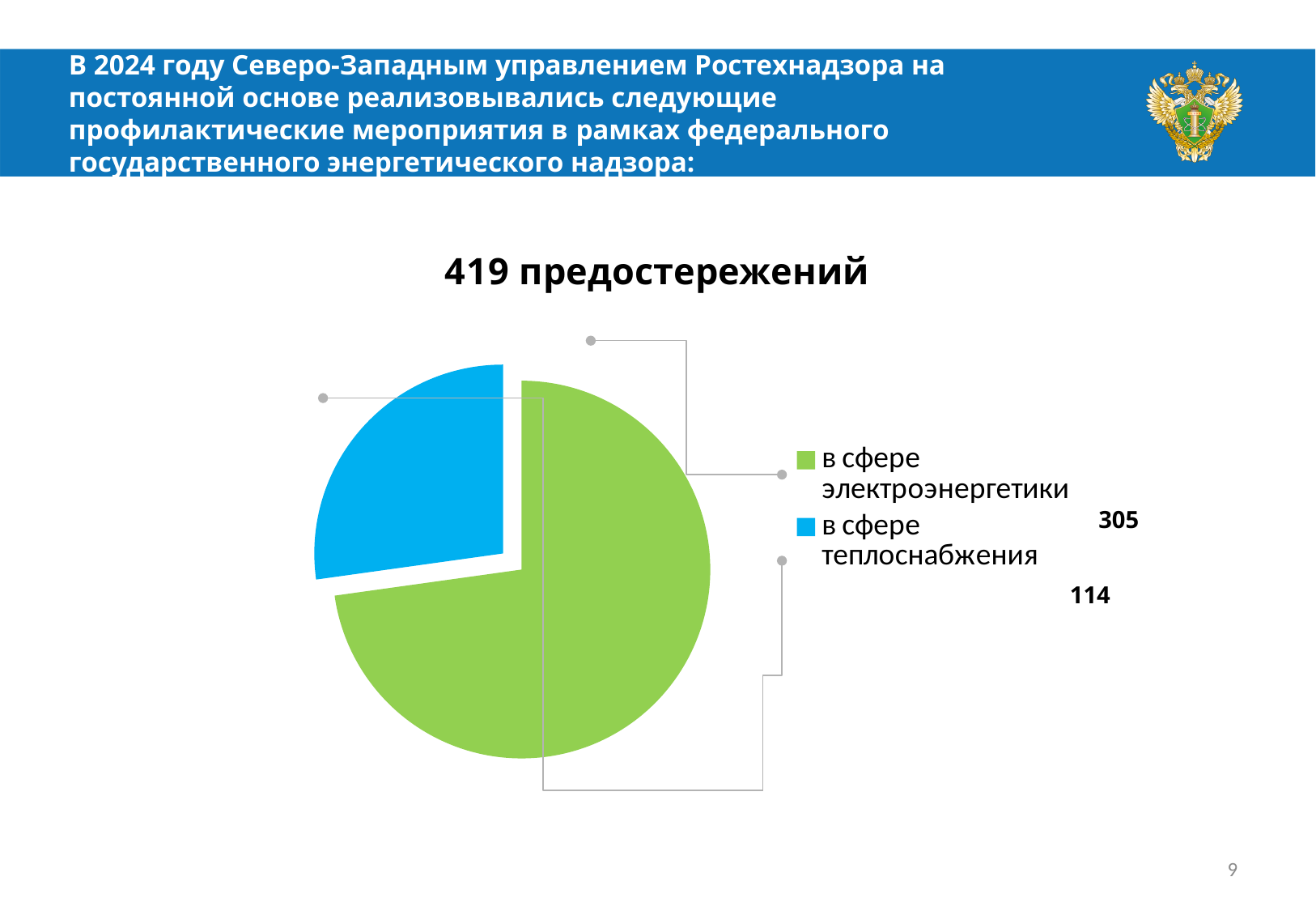
What is the difference between the values for "в сфере электроэнергетики" and "в сфере теплоснабжения"? 191 What kind of chart is shown on the slide? pie chart Which is larger: the value for "в сфере электроэнергетики" or for "в сфере теплоснабжения"? в сфере электроэнергетики How many slices does the pie chart have? 2 What colour is the slice for "в сфере теплоснабжения"? blue How many entries does the legend list? 2 Which category has the largest slice of the pie? в сфере электроэнергетики What is the total of the two slices in the pie chart? 419 What is the title of the chart? 419 предостережений What is the value for "в сфере теплоснабжения"? 114 What is the value for "в сфере электроэнергетики"? 305 Which category has the smallest slice of the pie? в сфере теплоснабжения